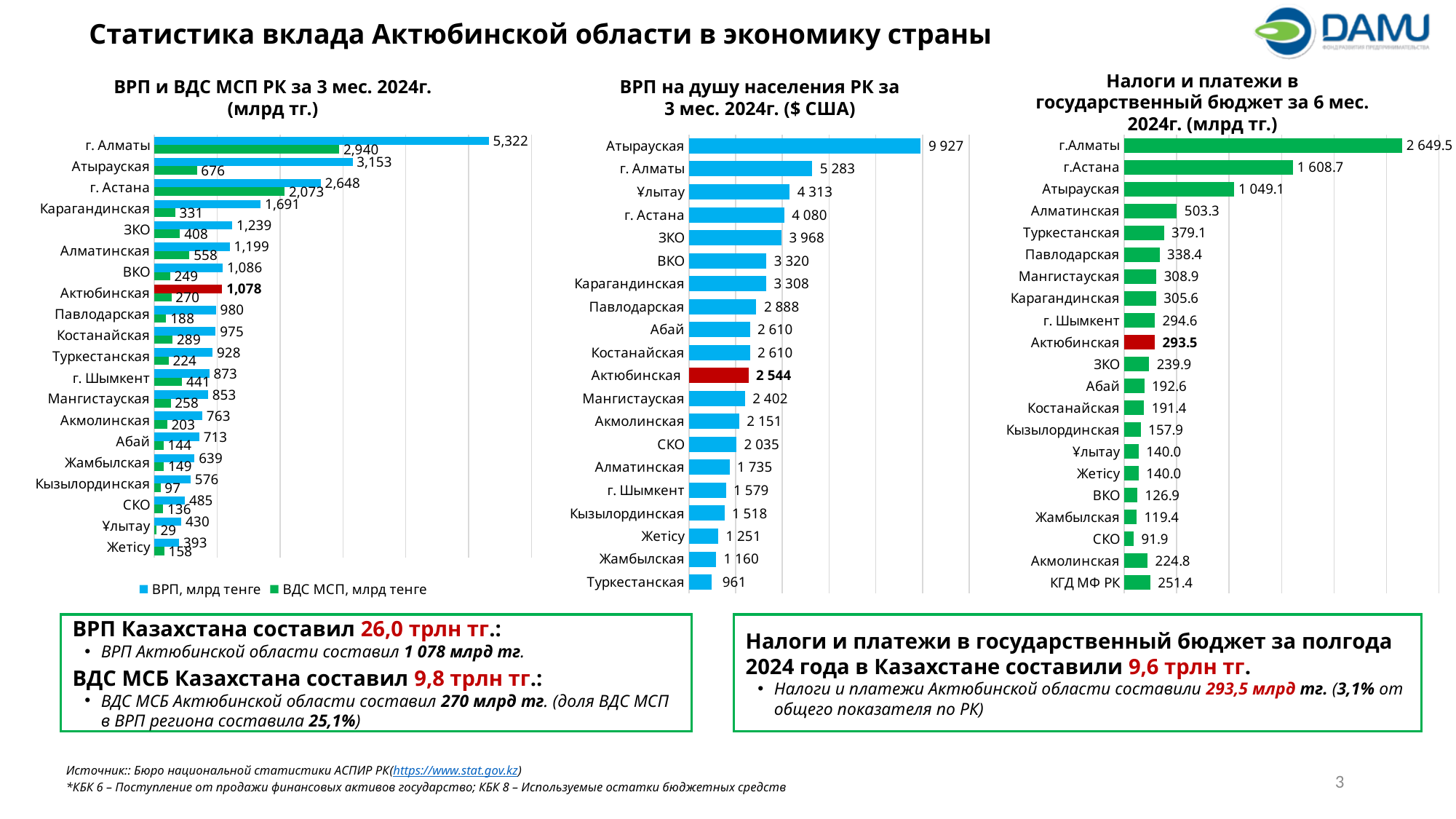
In the chart 'ВРП на душу населения РК за 3 мес. 2024г.', what is the value for Актюбинская? 2 544 In the chart 'ВРП и ВДС МСП РК за 3 мес. 2024г.', which region has the highest ВРП? г. Алматы In the chart 'ВРП на душу населения РК за 3 мес. 2024г.', how many regions are shown? 20 In the chart 'ВРП и ВДС МСП РК за 3 мес. 2024г.', what is the ВРП value for Актюбинская? 1,078 What type of chart is the 'Налоги и платежи в государственный бюджет за 6 мес. 2024г.' chart? Bar chart In the chart 'ВРП и ВДС МСП РК за 3 мес. 2024г.', what is the ВДС МСП value for г. Астана? 2,073 In the chart 'ВРП на душу населения РК за 3 мес. 2024г.', which region has the lowest value? Туркестанская In the chart 'Налоги и платежи в государственный бюджет за 6 мес. 2024г.', what is the value for Актюбинская? 293.5 In the chart 'Налоги и платежи в государственный бюджет за 6 мес. 2024г.', what is the difference between г.Алматы and г.Астана? 1 040.8 In the chart 'ВРП на душу населения РК за 3 мес. 2024г.', which is larger: the value for Ұлытау or for г. Астана? Ұлытау In the chart 'ВРП и ВДС МСП РК за 3 мес. 2024г.', what is the difference between the ВРП values of Атырауская and г. Астана? 505 In the chart 'ВРП и ВДС МСП РК за 3 мес. 2024г.', how many series does the legend list? 2